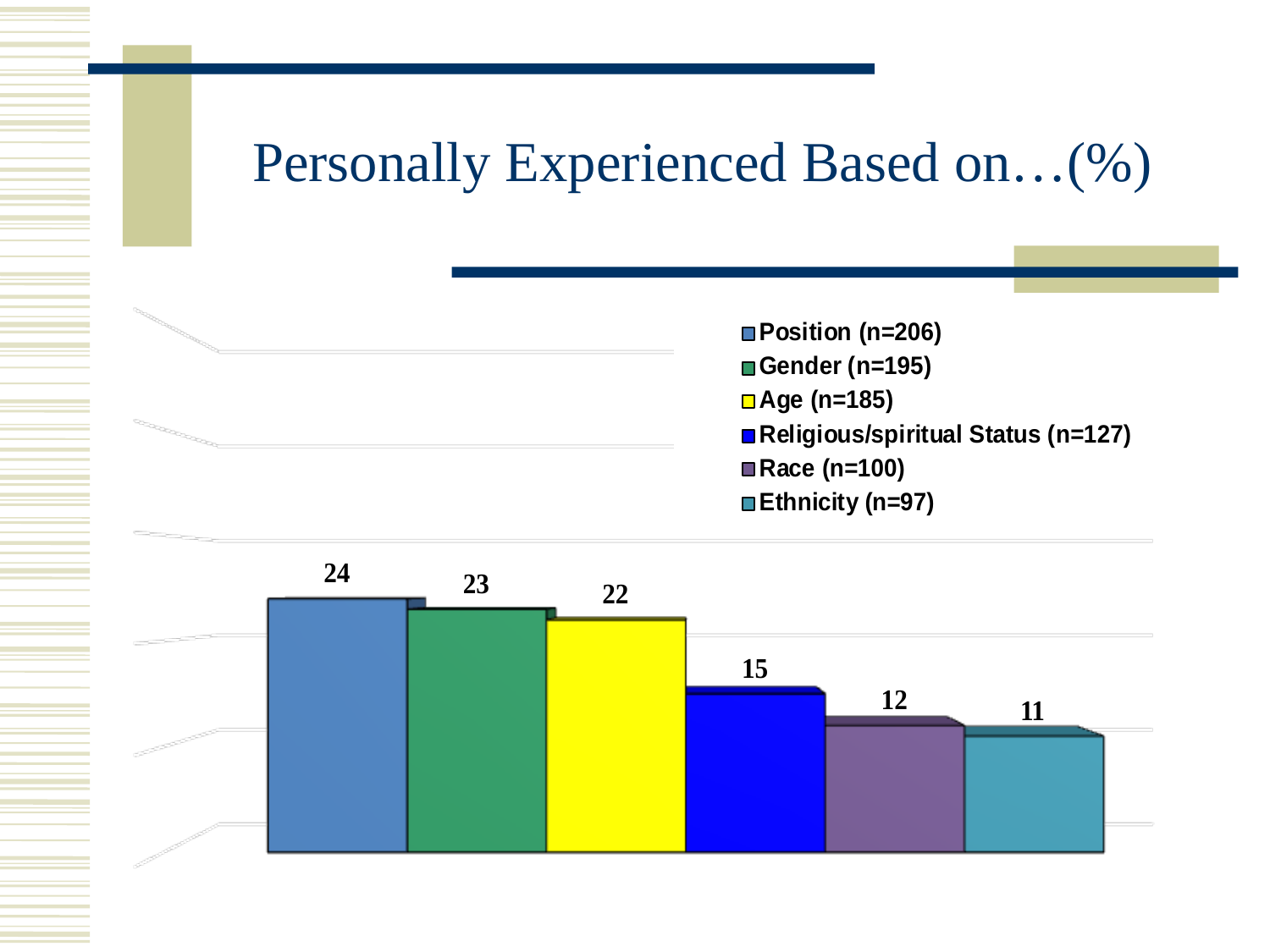
What kind of chart is shown on the slide? bar chart Which category has the lowest value? Ethnicity (n=97) What is the difference between the values for Position (n=206) and Race (n=100)? 12 How many entries does the legend list? 6 What is the title of the chart? Personally Experienced Based on…(%) Which is larger, the value for Gender (n=195) or the value for Race (n=100)? Gender (n=195) What is the value for Religious/spiritual Status (n=127)? 15 What is the difference between the values for Age (n=185) and Religious/spiritual Status (n=127)? 7 What is the value for Position (n=206)? 24 Which category has the highest value? Position (n=206) How many bars are plotted in the chart? 6 What is the value for Ethnicity (n=97)? 11